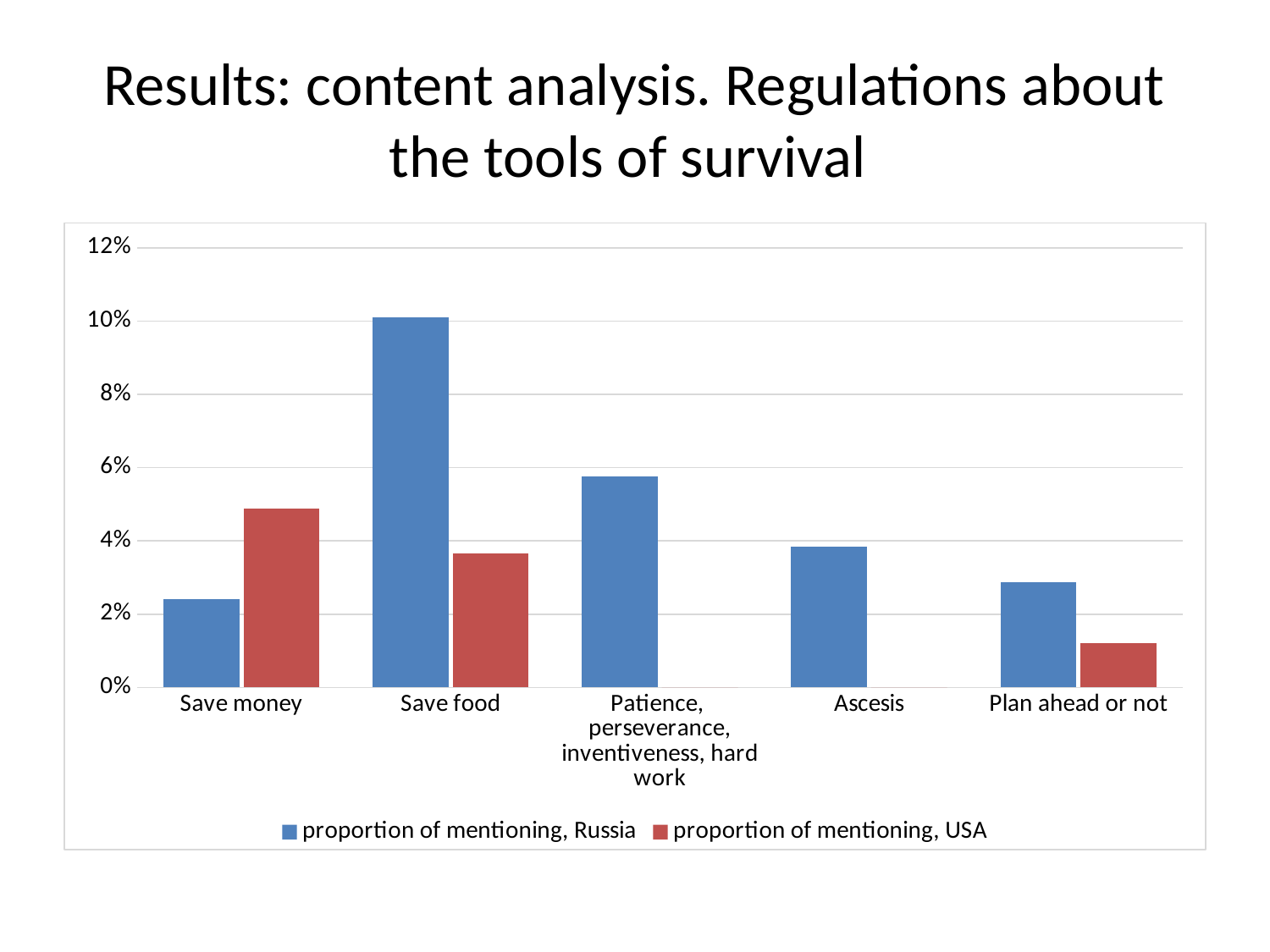
How many categories are shown on the x axis of the chart? 5 Among the categories with a USA bar, which has the lowest value for 'proportion of mentioning, USA'? Plan ahead or not Is the value for 'Save food' in the Russia series greater or less than 8%? greater For 'Save food', which series has the larger value: Russia or USA? Russia Which category has the highest value for 'proportion of mentioning, Russia'? Save food How many series does the chart's legend list? 2 Is the value for 'Plan ahead or not' in the USA series greater or less than 2%? less What colour are the bars for 'proportion of mentioning, USA'? red For 'Save money', which series has the larger value: Russia or USA? USA Which category has the highest value for 'proportion of mentioning, USA'? Save money Which category has the lowest value for 'proportion of mentioning, Russia'? Save money What kind of chart is shown on the slide? bar chart